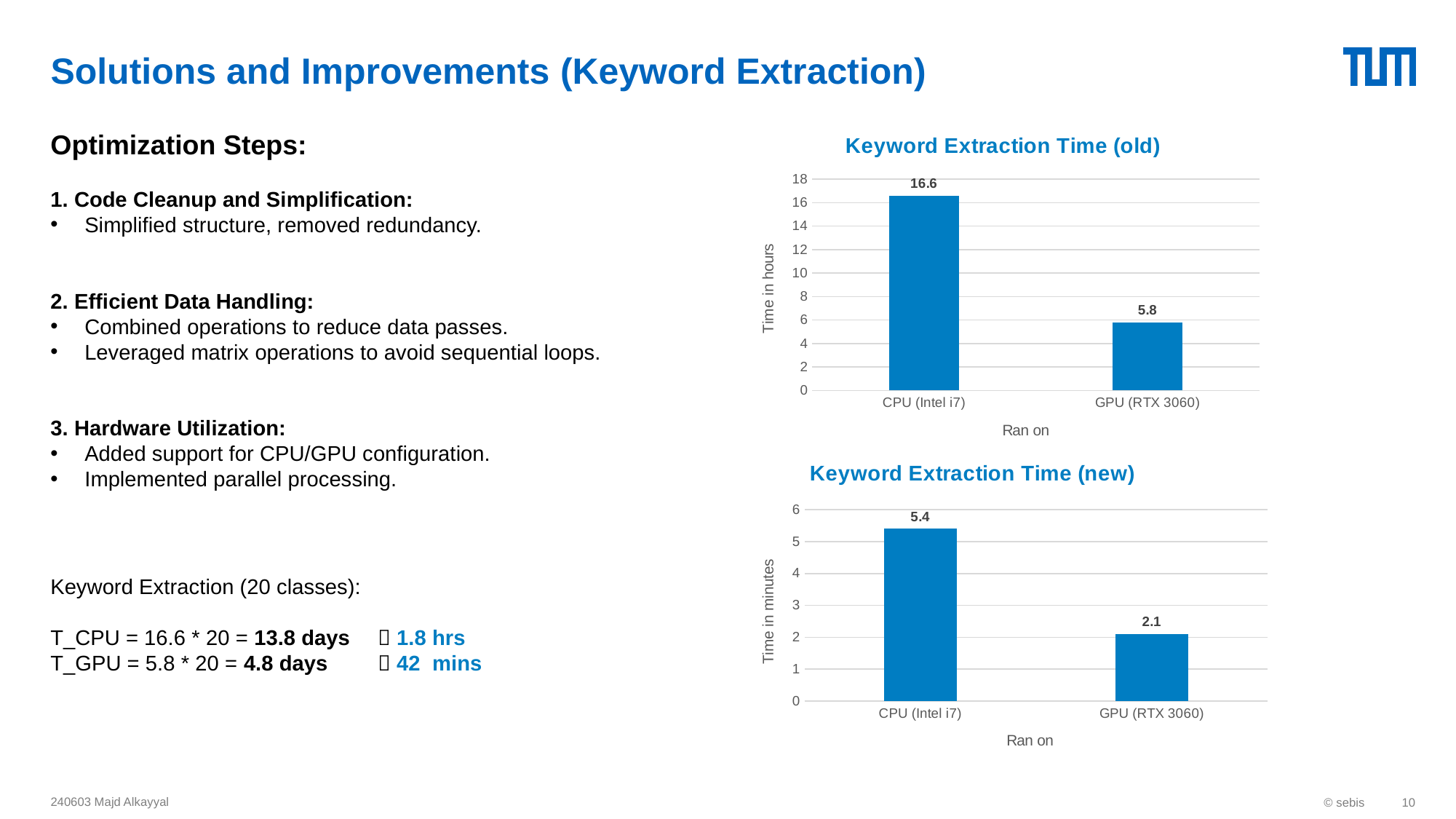
In the 'Keyword Extraction Time (old)' chart, which category has the highest value? CPU (Intel i7) In the 'Keyword Extraction Time (old)' chart, what is the value for CPU (Intel i7)? 16.6 How many categories are shown in the 'Keyword Extraction Time (old)' chart? 2 In the 'Keyword Extraction Time (old)' chart, what is the value for GPU (RTX 3060)? 5.8 In the 'Keyword Extraction Time (new)' chart, which is larger, the value for CPU (Intel i7) or GPU (RTX 3060)? CPU (Intel i7) In the 'Keyword Extraction Time (new)' chart, what is the value for CPU (Intel i7)? 5.4 What is the y-axis label of the 'Keyword Extraction Time (new)' chart? Time in minutes In the 'Keyword Extraction Time (new)' chart, which category has the lowest value? GPU (RTX 3060) What kind of chart is the 'Keyword Extraction Time (new)' chart? Bar chart In the 'Keyword Extraction Time (new)' chart, what is the difference between the CPU (Intel i7) and GPU (RTX 3060) values? 3.3 In the 'Keyword Extraction Time (new)' chart, what is the value for GPU (RTX 3060)? 2.1 In the 'Keyword Extraction Time (old)' chart, what is the difference between the CPU (Intel i7) and GPU (RTX 3060) values? 10.8